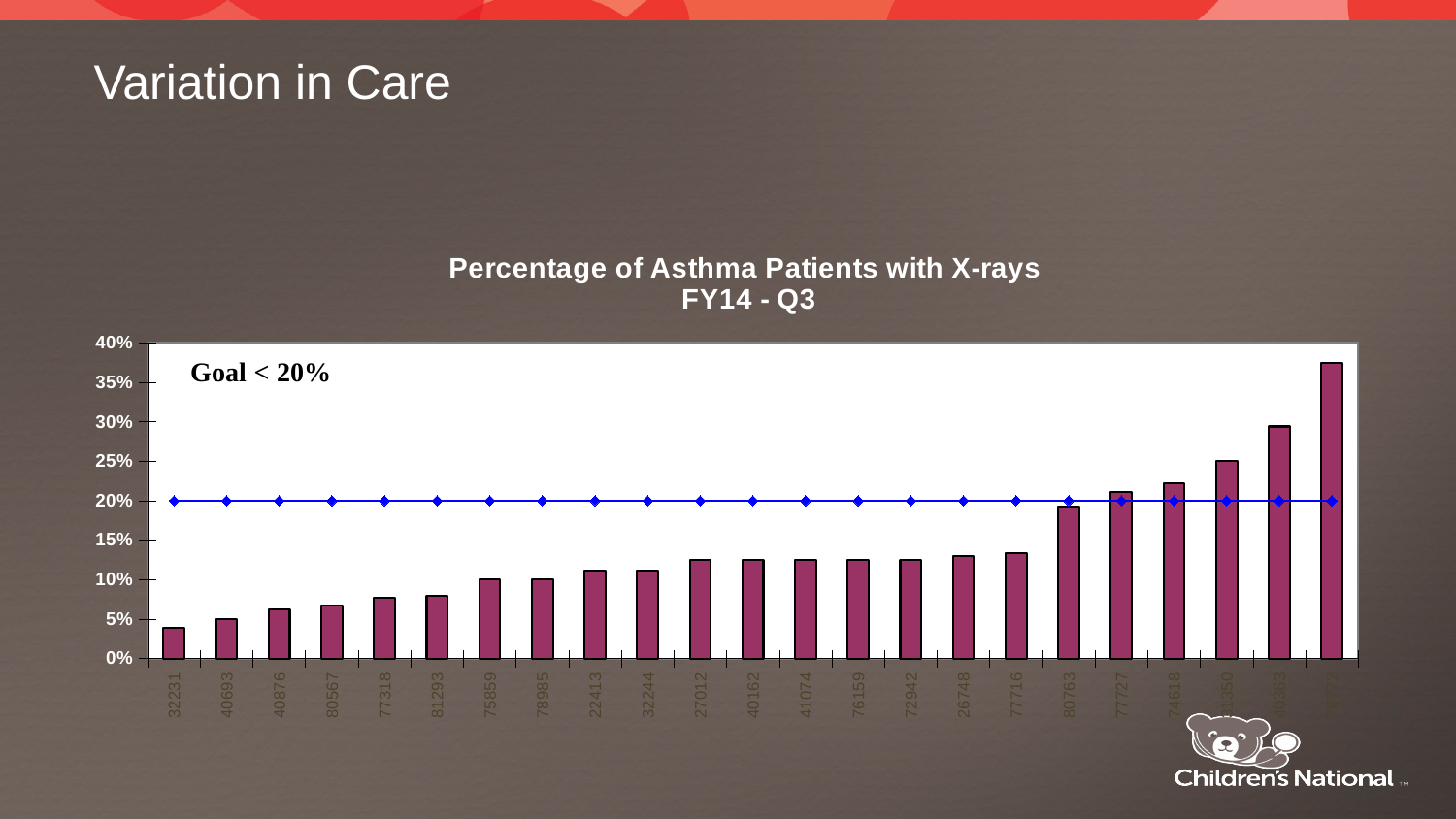
What goal is stated in the annotation on the chart? Goal < 20% What is the title of the chart? Percentage of Asthma Patients with X-rays FY14 - Q3 What kind of chart is shown on the slide? bar chart Is the value for 74618 greater or less than 25%? less How many bars are plotted in the chart? 23 Which has the larger value, 74618 or 26748? 74618 Do the bar values rise or fall from left to right along the x axis? rise Is the value for 26748 greater or less than 15%? less Is the value for 77318 greater or less than 10%? less Which of the labelled categories has the lowest value? 32231